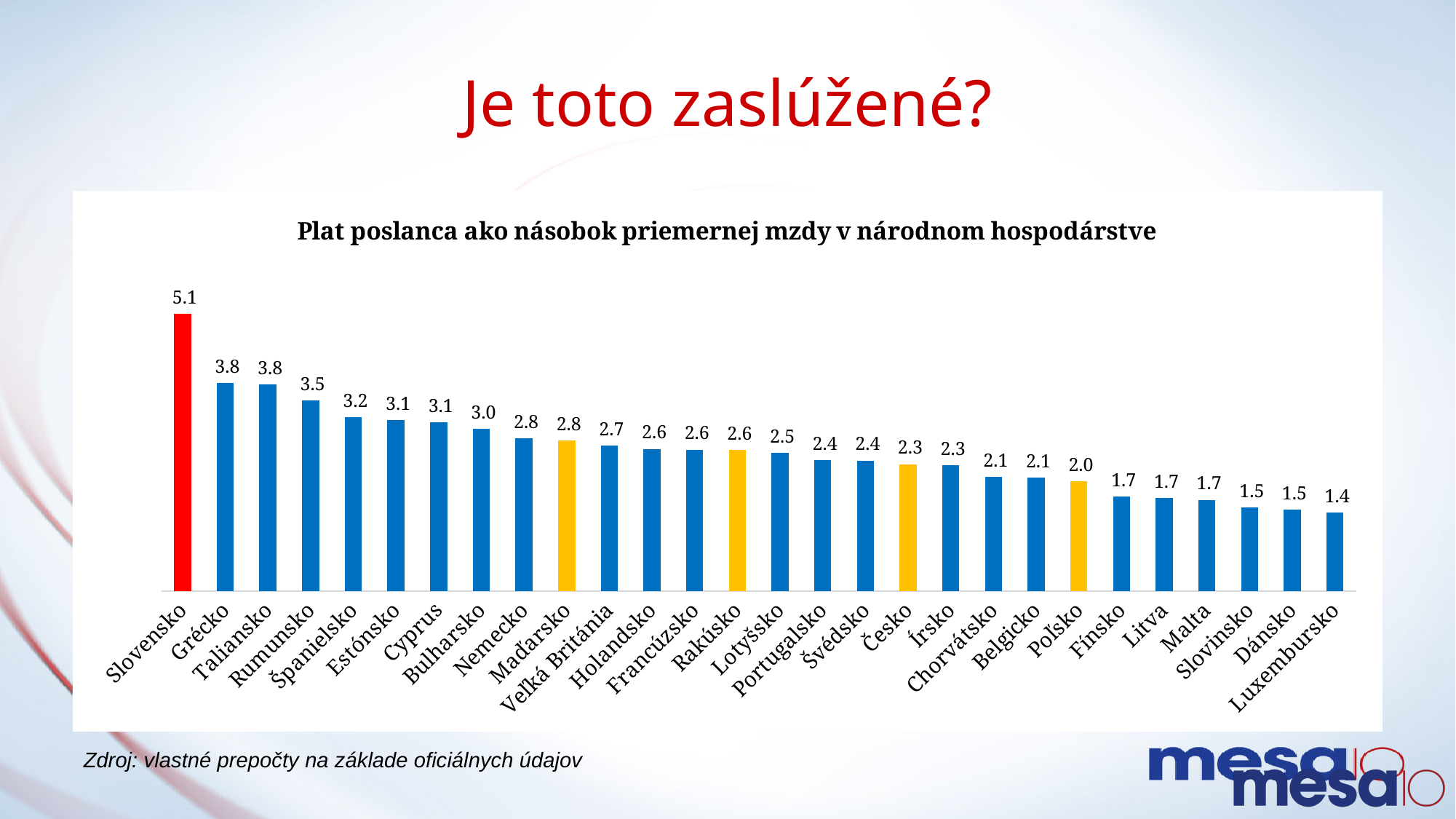
Which country has the lowest value? Luxembursko What is the difference between the values for Slovensko and Grécko? 1.3 How many countries are shown in the chart? 28 Do the values rise or fall from left to right along the x axis? Fall Which is larger, the value for Rumunsko or the value for Nemecko? Rumunsko What is the value for Poľsko? 2.0 What is the value for Česko? 2.3 What kind of chart is shown on the slide? Bar chart Which country has the highest value? Slovensko What is the title of the chart? Plat poslanca ako násobok priemernej mzdy v národnom hospodárstve What is the value for Slovensko? 5.1 What is the difference between the values for Maďarsko and Rakúsko? 0.2